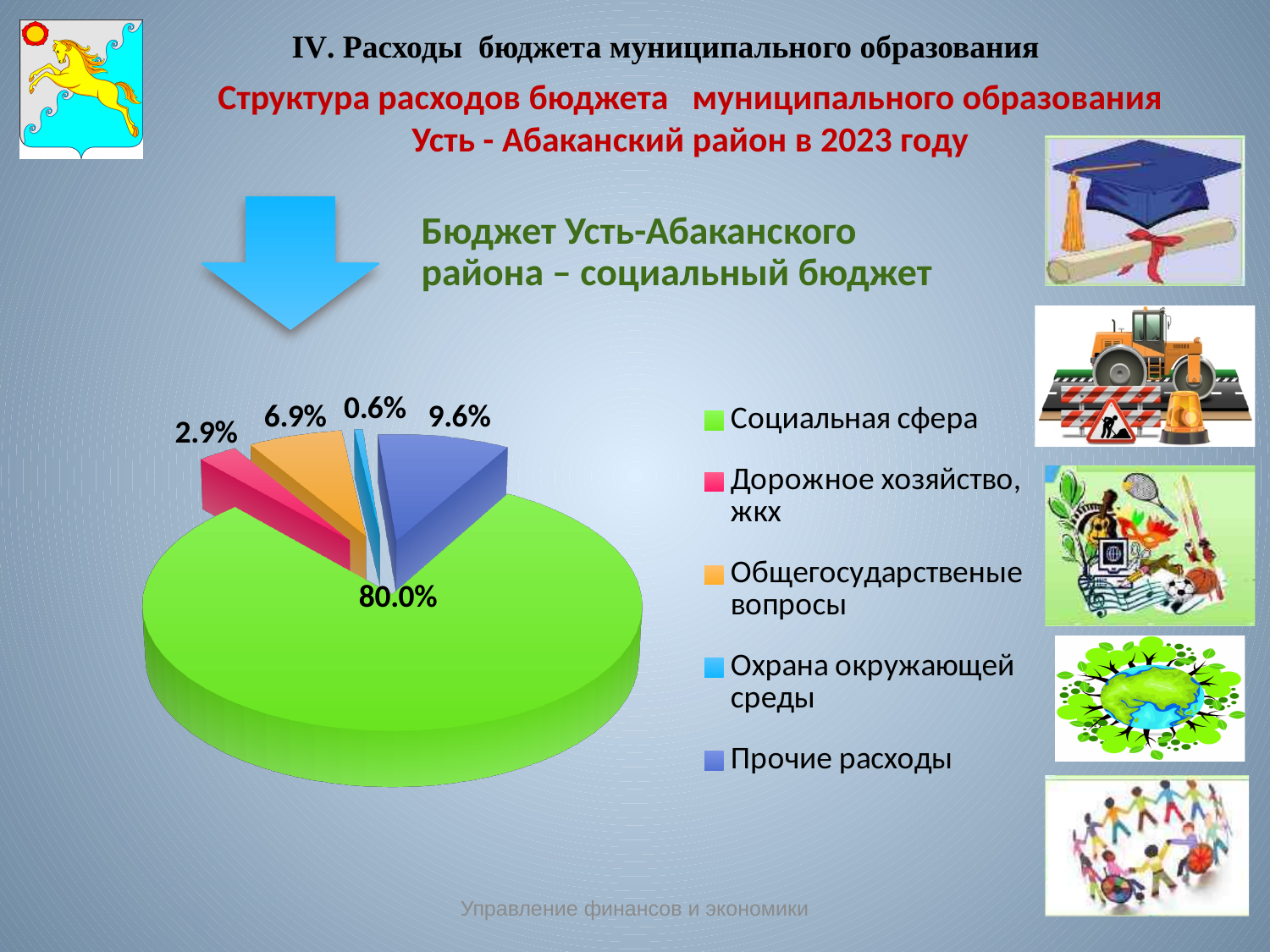
What kind of chart is shown on the slide? pie chart How many categories does the legend of the pie chart list? 5 Which category has the smallest slice of the pie? Охрана окружающей среды Which is larger, the share for Дорожное хозяйство, жкх or the share for Общегосударственые вопросы? Общегосударственые вопросы What share of the pie does Социальная сфера have? 80.0% What colour is the slice for Социальная сфера? green What is the difference between the shares of Прочие расходы and Общегосударственые вопросы? 2.7% What is the value shown for Общегосударственые вопросы? 6.9% What is the value shown for Прочие расходы? 9.6% What is the value shown for Дорожное хозяйство, жкх? 2.9% Which category has the largest slice of the pie? Социальная сфера What is the value shown for Охрана окружающей среды? 0.6%